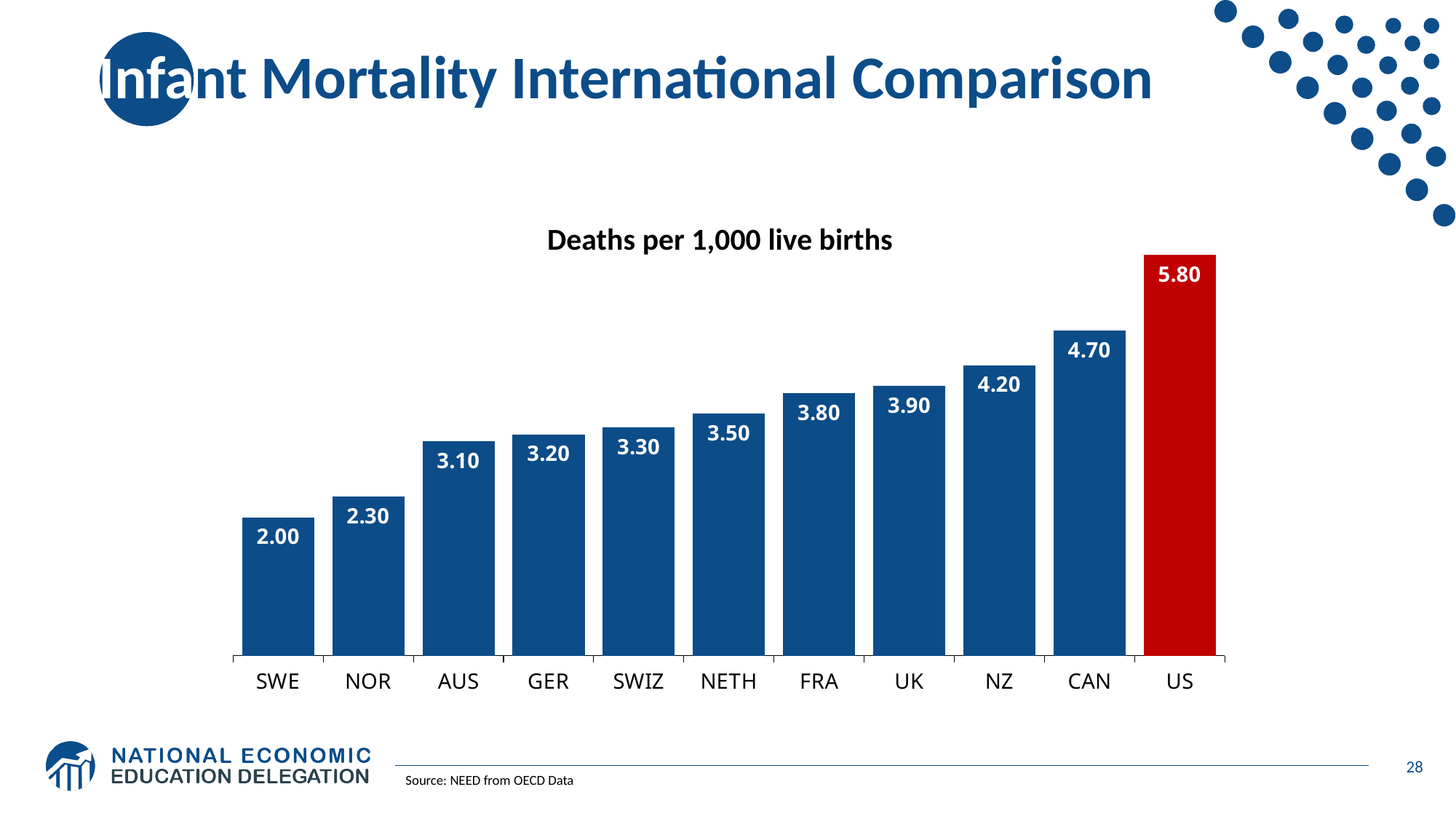
What kind of chart is this? Bar chart Which country has the lowest value? SWE What is the title shown above the chart? Deaths per 1,000 live births How many countries are shown in the chart? 11 What is the value for the US? 5.80 What is the difference between the values for the US and CAN? 1.10 What is the difference between the values for NOR and SWE? 0.30 What is the value for NZ? 4.20 Which is larger, the value for FRA or the value for UK? UK What is the value for GER? 3.20 Which country has the highest value? US Do the values rise or fall from left to right along the x axis? Rise